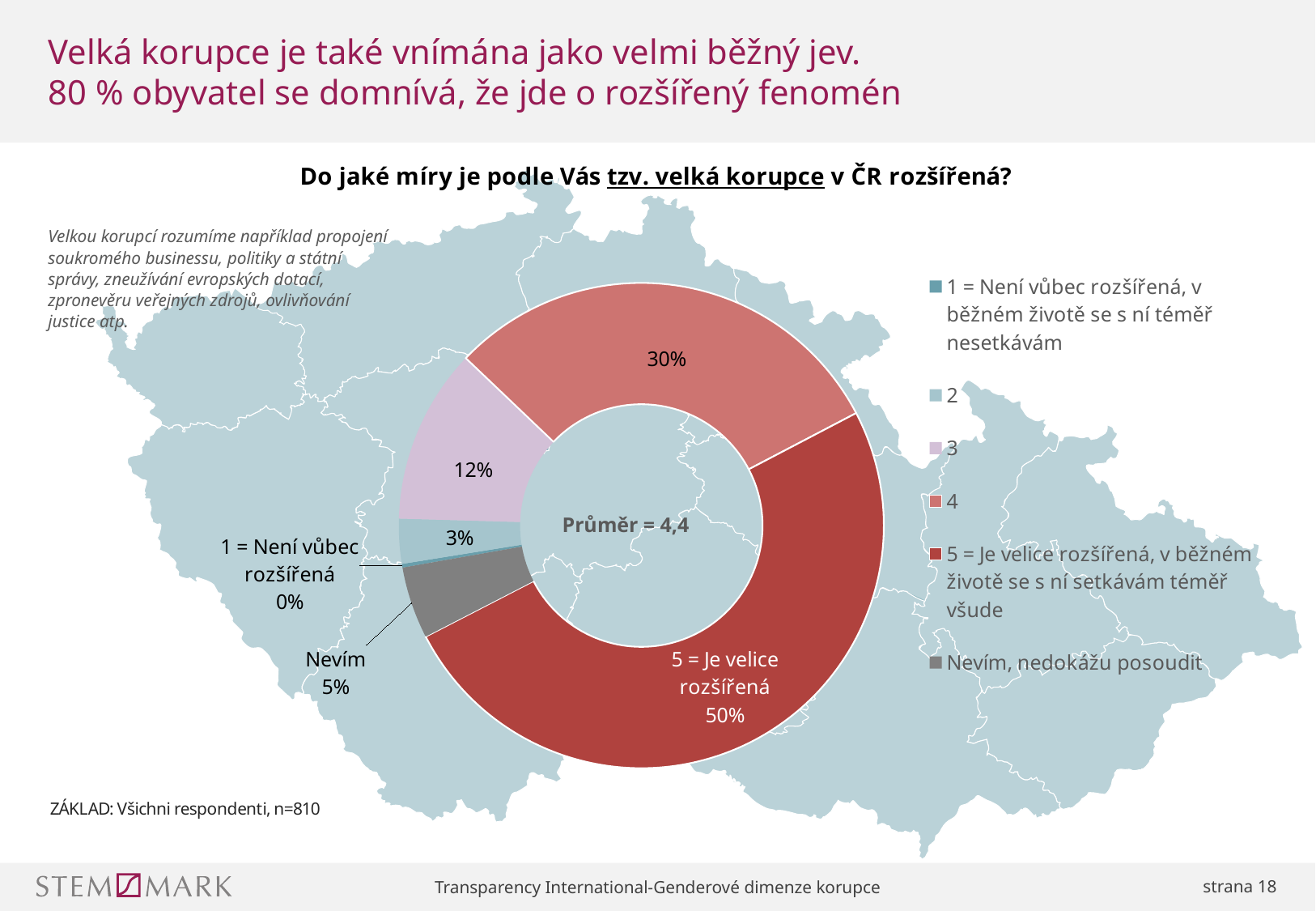
What share of respondents answered "3"? 12% What type of chart is shown on the slide? Donut (pie) chart What share of respondents answered "1 = Není vůbec rozšířená"? 0% What share of respondents answered "Nevím, nedokážu posoudit"? 5% Which answer category has the largest share of the chart? 5 = Je velice rozšířená What average value (Průměr) is shown in the centre of the chart? 4,4 Which is larger: the share for answer 3 or the share for "Nevím"? Answer 3 What share of respondents answered "4"? 30% What is the difference in percentage points between the shares for answer 5 and answer 4? 20 percentage points What share of respondents answered "5 = Je velice rozšířená"? 50% Which answer category has the smallest share of the chart? 1 = Není vůbec rozšířená What share of respondents answered "2"? 3%